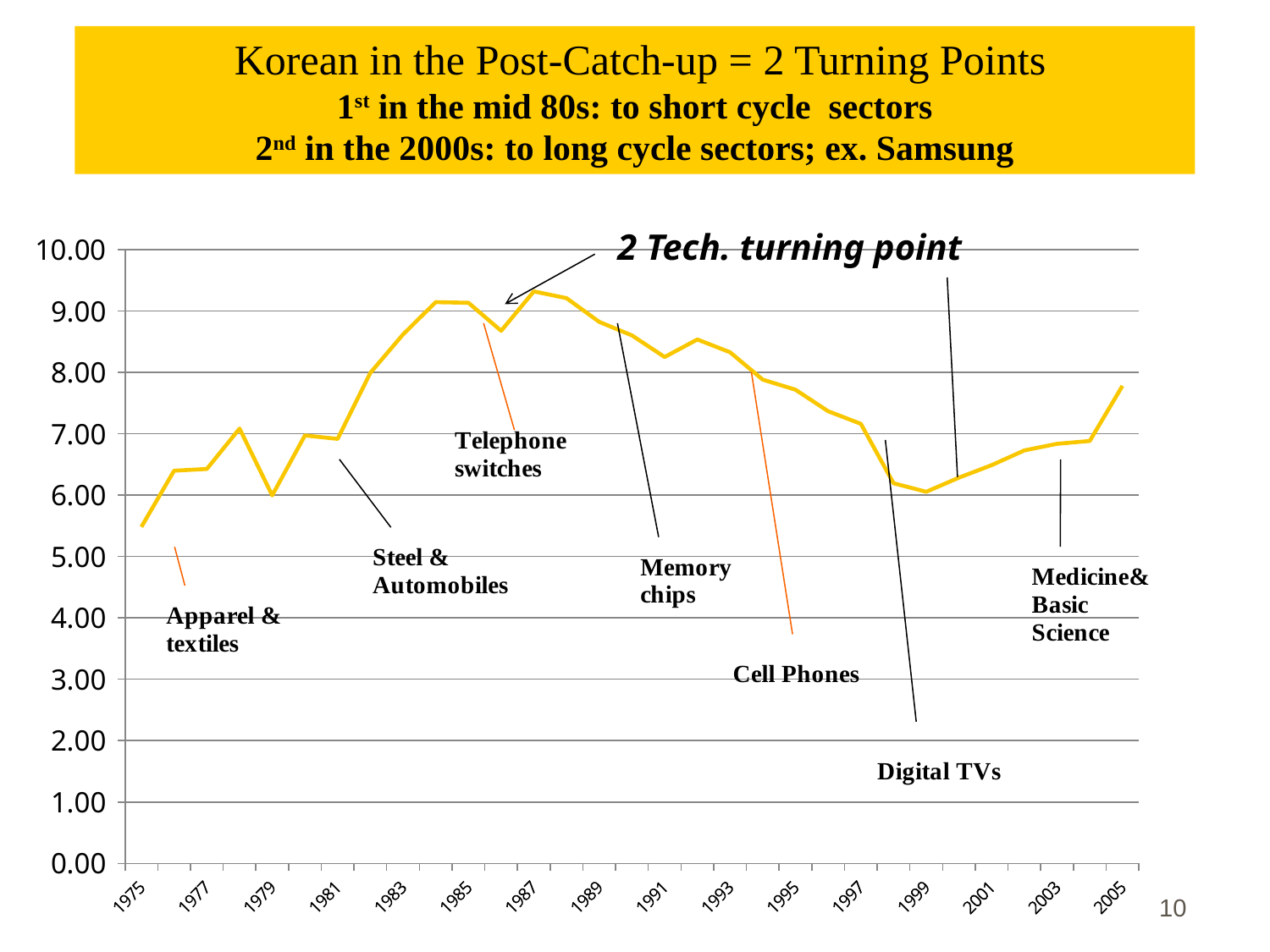
Is the value for 1975 greater or less than 6.00? less Which year has the lowest value on the line? 1975 Which sector label is annotated near the low point of the line around 1999? Digital TVs What kind of chart is shown on the slide? line chart Does the line rise or fall between 1987 and 1999? fall Is the value for 2005 greater or less than 7.00? greater Which is larger, the value for 1987 or the value for 1999? 1987 Is the value for 1999 greater or less than 7.00? less Which is larger, the value for 1975 or the value for 2005? 2005 How many year labels are shown on the x axis? 16